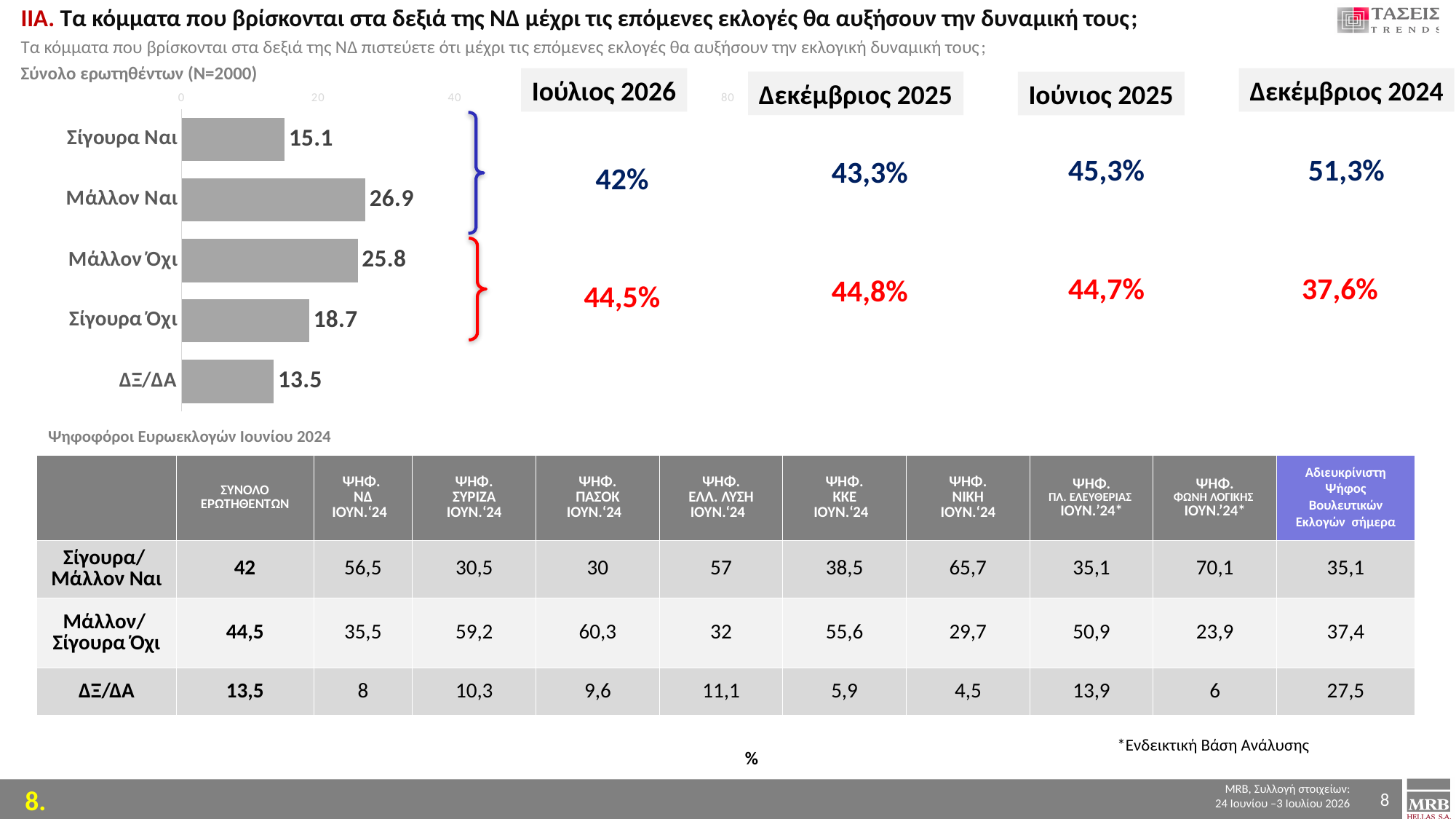
Which category has the highest value in the bar chart? Μάλλον Ναι What is the difference between the values for Σίγουρα Όχι and ΔΞ/ΔΑ in the bar chart? 5.2 Which category has the lowest value in the bar chart? ΔΞ/ΔΑ What is the value for Σίγουρα Ναι in the bar chart? 15.1 Is the value for Σίγουρα Ναι in the bar chart greater or less than 20? less What is the difference between the values for Μάλλον Ναι and Σίγουρα Ναι in the bar chart? 11.8 How many categories are shown in the bar chart? 5 What is the value for ΔΞ/ΔΑ in the bar chart? 13.5 In the bar chart, which is larger: the value for Μάλλον Ναι or the value for Μάλλον Όχι? Μάλλον Ναι What colour are the bars in the bar chart? grey What is the value for Μάλλον Όχι in the bar chart? 25.8 What kind of chart is shown on the slide? bar chart